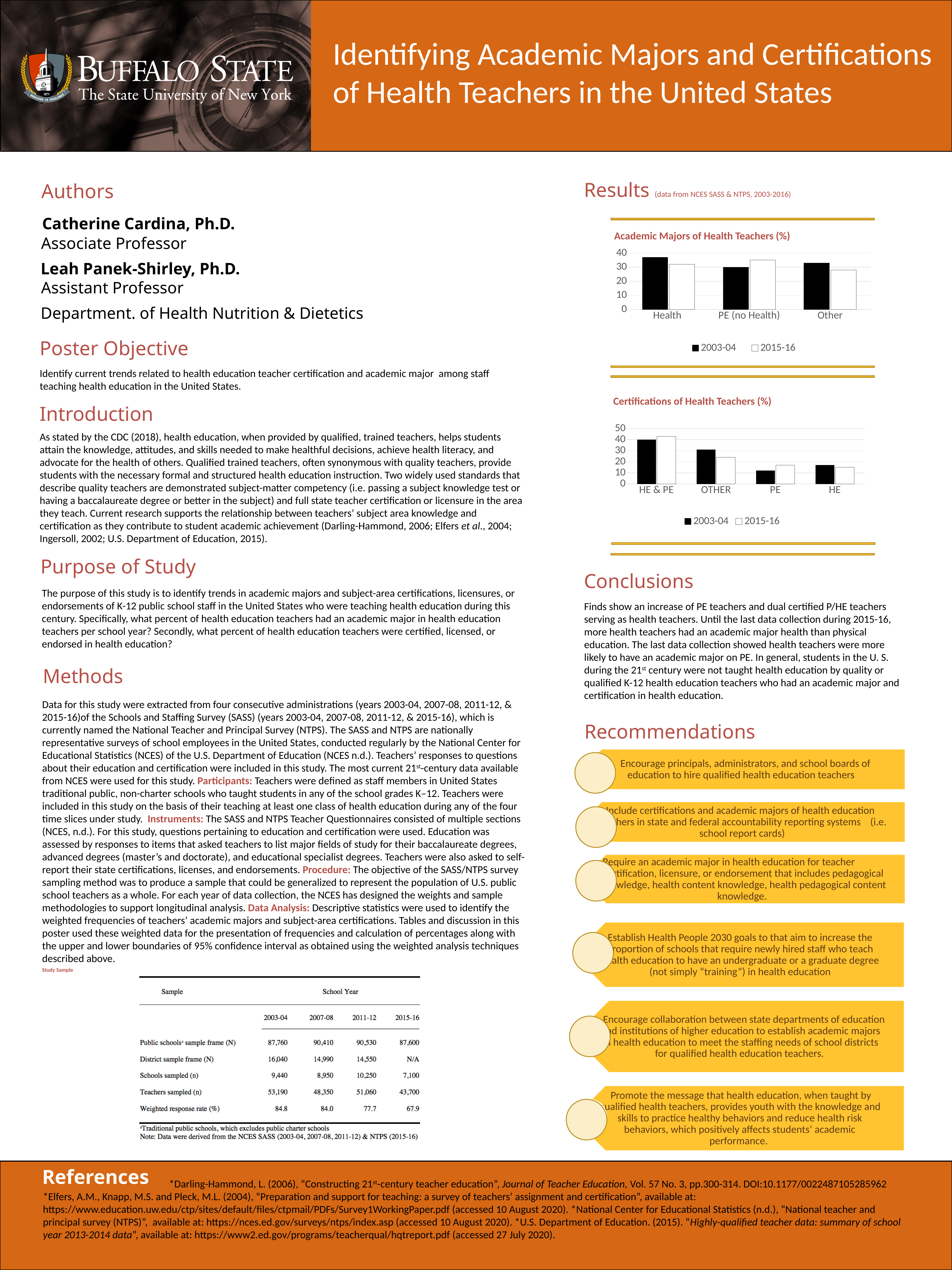
How many series does the legend of the 'Certifications of Health Teachers (%)' chart list? 2 In the 'Certifications of Health Teachers (%)' chart, is the 2015-16 value for HE & PE greater or less than 40? greater In the 'Academic Majors of Health Teachers (%)' chart, which series has the larger value for PE (no Health), 2003-04 or 2015-16? 2015-16 In the 'Certifications of Health Teachers (%)' chart, which category has the highest 2003-04 value? HE & PE In the 'Certifications of Health Teachers (%)' chart, which category has the lowest 2003-04 value? PE How many categories are shown on the x axis of the 'Certifications of Health Teachers (%)' chart? 4 What kind of chart is the 'Academic Majors of Health Teachers (%)' chart? bar chart In the 'Academic Majors of Health Teachers (%)' chart, is the 2003-04 value for Health greater or less than 30? greater What are the two legend entries in the 'Academic Majors of Health Teachers (%)' chart? 2003-04 and 2015-16 How many categories are shown on the x axis of the 'Academic Majors of Health Teachers (%)' chart? 3 In the 'Academic Majors of Health Teachers (%)' chart, which series has the larger value for Health, 2003-04 or 2015-16? 2003-04 In the 'Certifications of Health Teachers (%)' chart, is the 2003-04 value for PE greater or less than 20? less